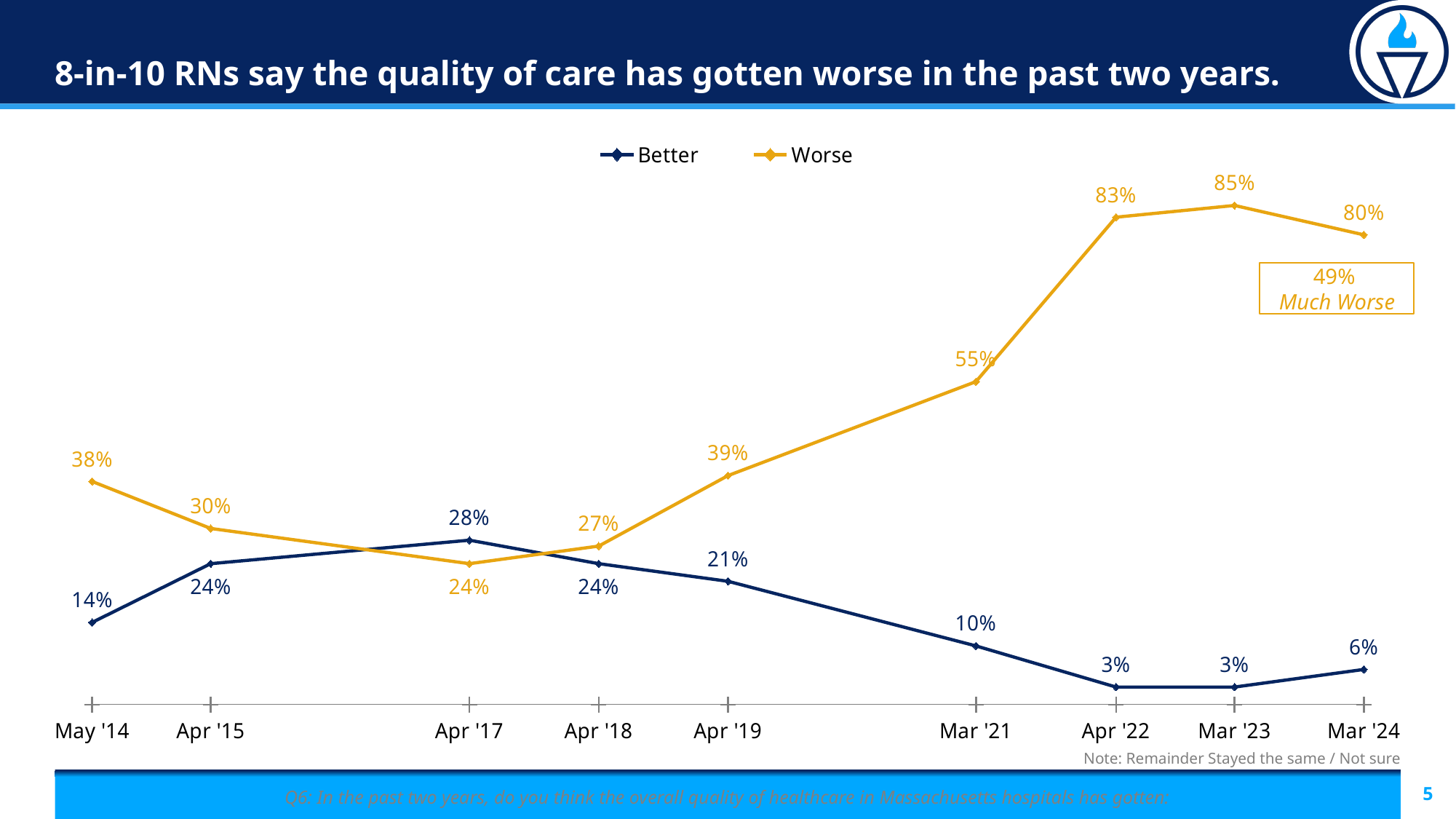
What is the value for Better in Apr '17? 28% What is the value for Worse in Apr '19? 39% What is the difference between Worse and Better in Mar '24? 74 percentage points What is the value for Worse in Mar '23? 85% Does the Better series rise or fall from Apr '17 to Mar '23? Fall What type of chart is shown on the slide? Line chart Which series has the larger value in Apr '17, Better or Worse? Better At which time point is the Better series highest? Apr '17 At which time point is the Worse series highest? Mar '23 How many series does the legend list? 2 What percentage is shown in the boxed annotation labelled Much Worse? 49% How many time points are plotted along the x axis? 9